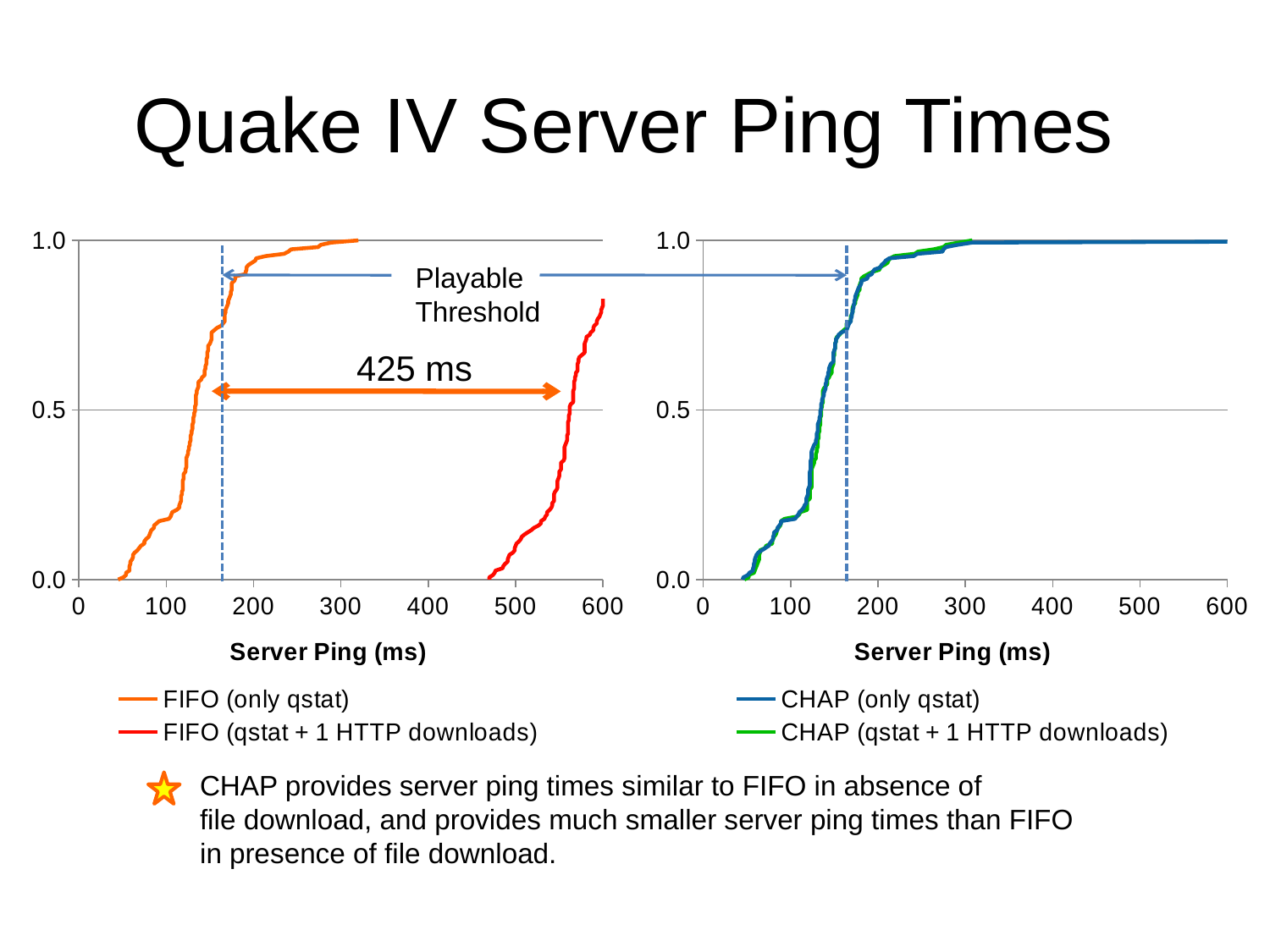
In the right chart, is the value of CHAP (qstat + 1 HTTP downloads) at 300 ms greater or less than 0.5? greater What is the maximum value shown on the x axis of the right chart? 600 What kind of chart is the left chart on the slide? line chart What is the x-axis label of the left chart? Server Ping (ms) In the left chart, is the value of FIFO (qstat + 1 HTTP downloads) at 500 ms greater or less than 0.5? less In the left chart, at 300 ms, which series has the higher value: FIFO (only qstat) or FIFO (qstat + 1 HTTP downloads)? FIFO (only qstat) In the right chart, is the value of CHAP (only qstat) at 100 ms greater or less than 0.5? less How many series does the legend of the left chart list? 2 In the right chart, do the CHAP curves rise or fall as Server Ping increases along the x axis? rise How many series does the legend of the right chart list? 2 In the left chart, what gap in milliseconds is annotated between the two FIFO curves? 425 ms